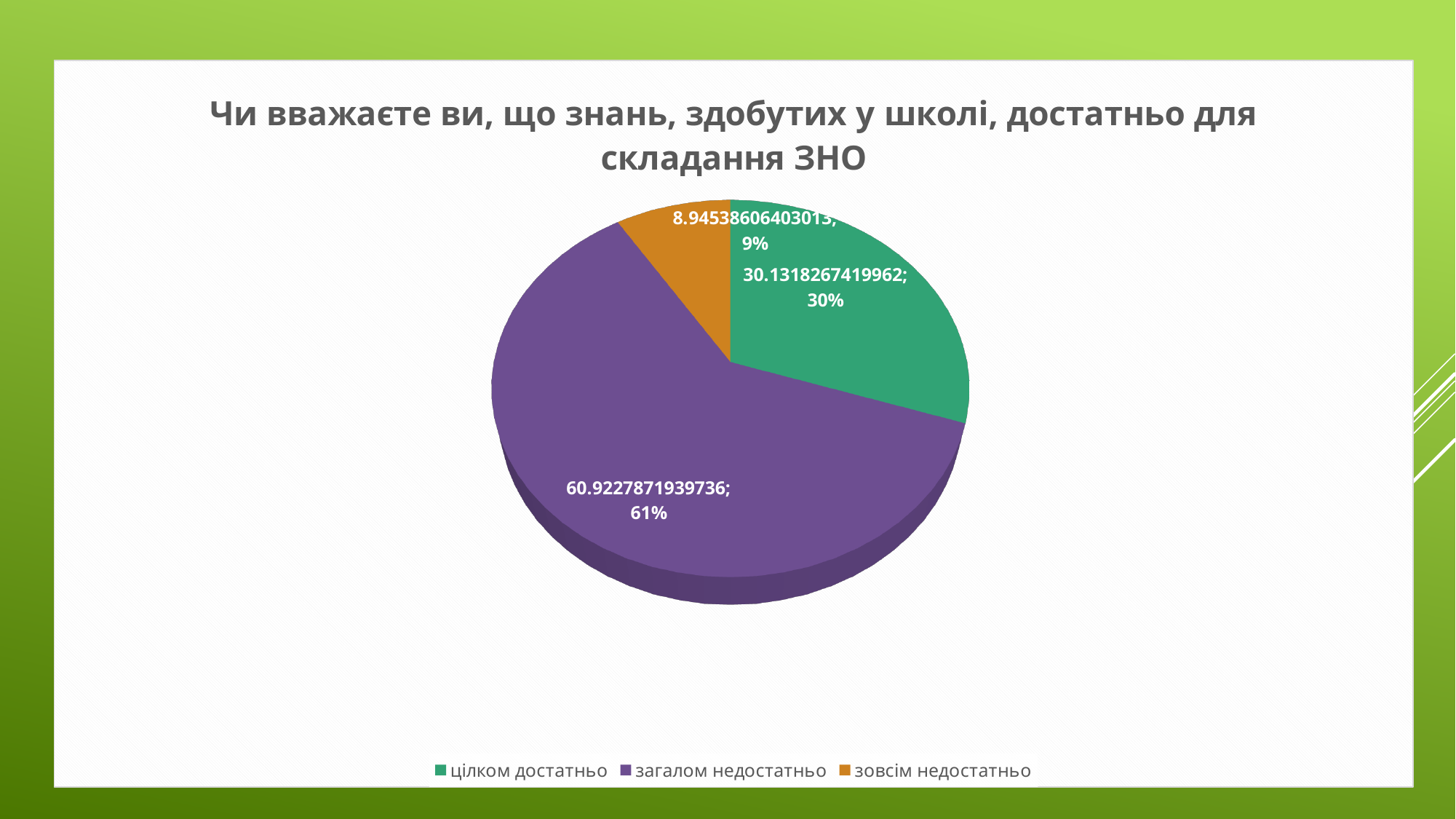
What percentage share is shown for "зовсім недостатньо"? 9% What value is printed on the data label for the "зовсім недостатньо" slice? 8.94538606403013 What percentage share is shown for "цілком достатньо"? 30% How many categories does the legend list? 3 What value is printed on the data label for the "цілком достатньо" slice? 30.1318267419962 What percentage share is shown for "загалом недостатньо"? 61% Which category has the largest slice of the pie? загалом недостатньо Which is larger: the share for "цілком достатньо" or the share for "зовсім недостатньо"? цілком достатньо What value is printed on the data label for the "загалом недостатньо" slice? 60.9227871939736 What colour is the "загалом недостатньо" slice? purple What kind of chart is shown on the slide? pie chart Which category has the smallest slice of the pie? зовсім недостатньо